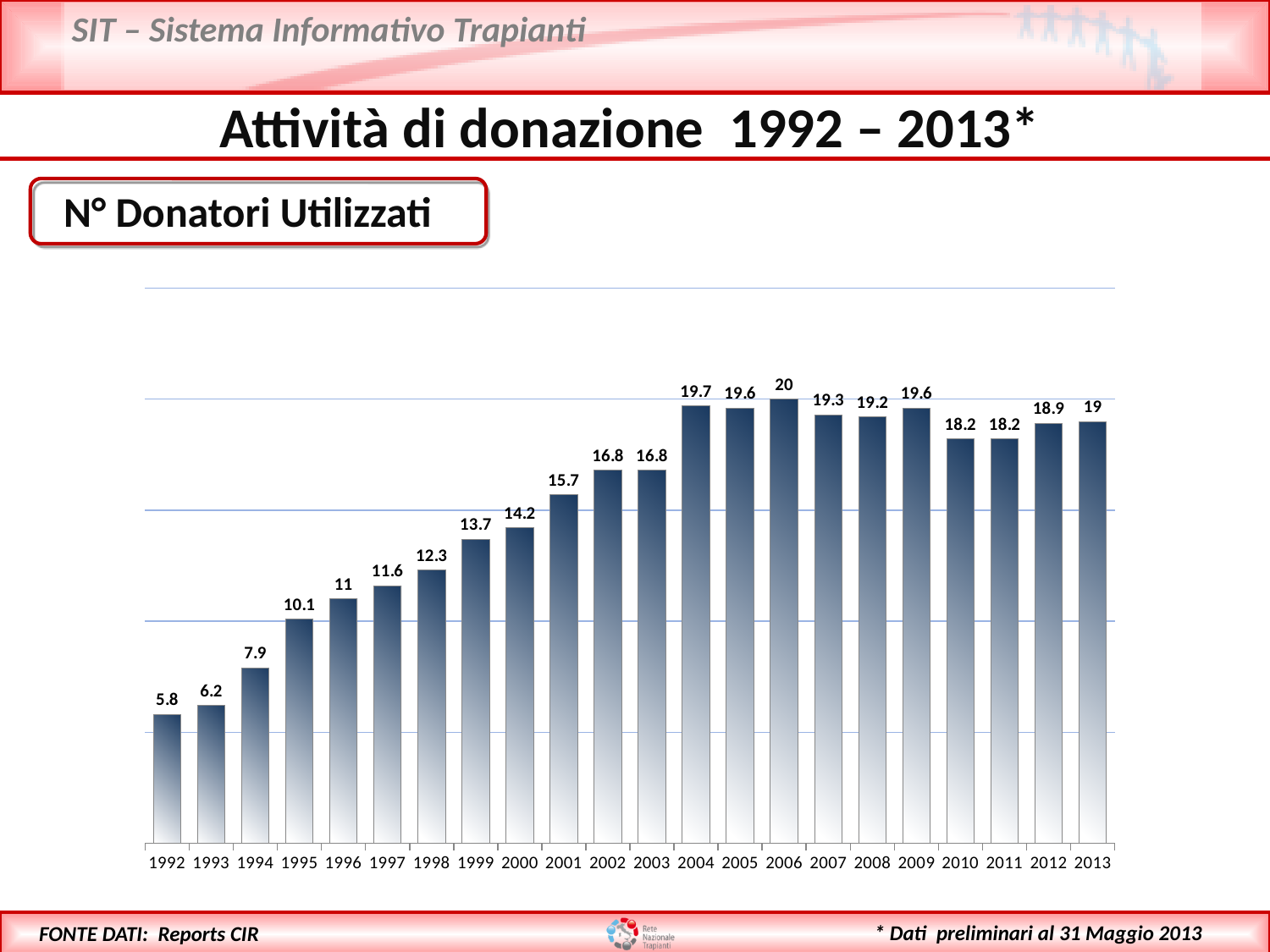
Do the values generally rise or fall from 1992 to 2006? Rise What is the difference between the values for 2006 and 1992? 14.2 What is the value for 1999? 13.7 Which year has the highest value? 2006 What is the value for 1992? 5.8 What is the difference between the values for 2004 and 2010? 1.5 Which is larger, the value for 2001 or the value for 2012? 2012 What is the value for 2013? 19 Which year has the lowest value? 1992 What kind of chart is shown on the slide? Bar chart What is the value for 2006? 20 How many years are shown on the x axis? 22